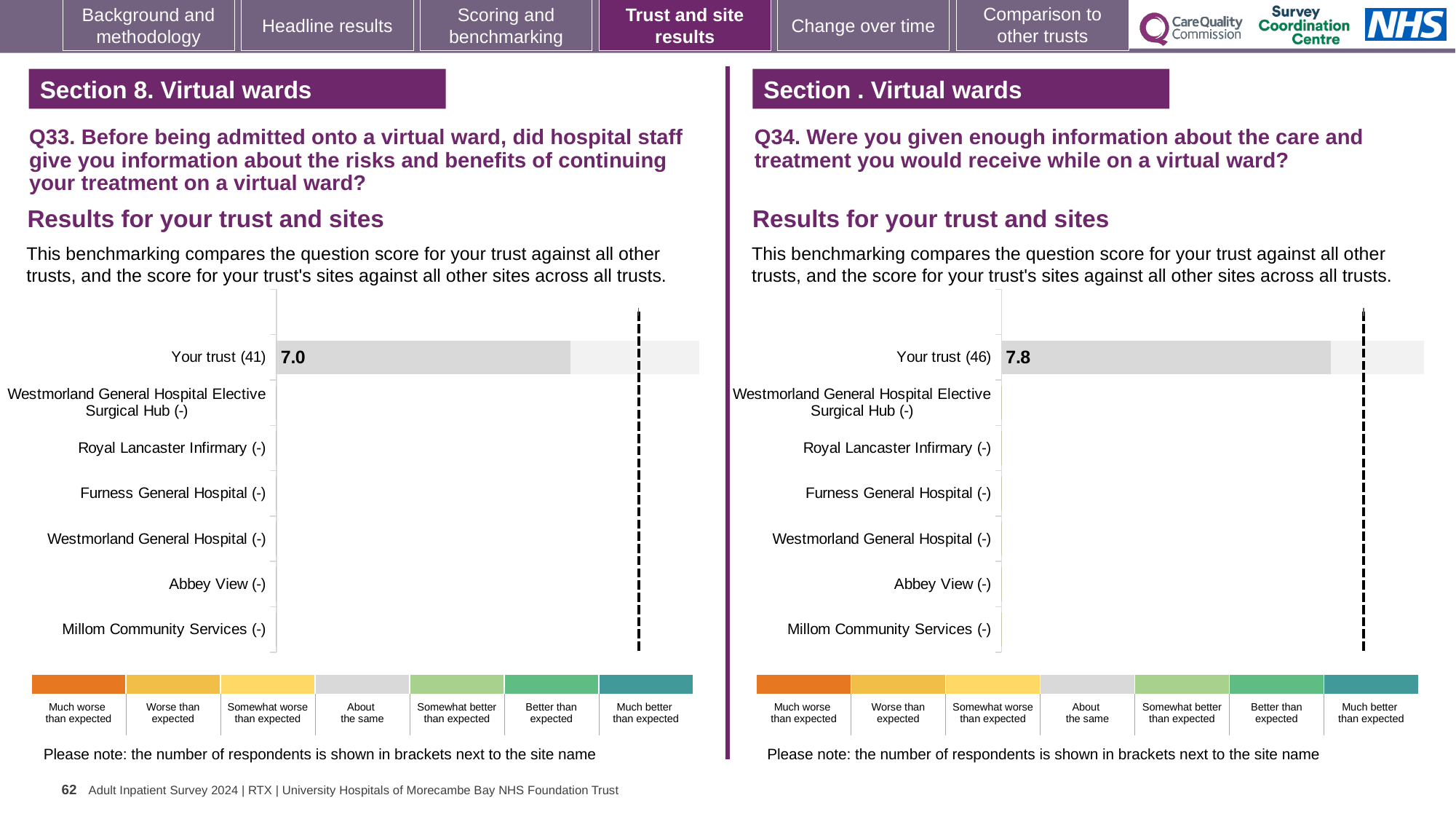
In the Q34 chart on the right, what is the label of the last row on the y axis? Millom Community Services (-) How many rows (categories) are listed on the y axis of the Q33 chart on the left? 7 What kind of chart is the Q33 chart on the left? Bar chart In the Q33 chart on the left, which row is the only one with a plotted bar? Your trust (41) In the Q33 chart on the left, what is the score shown for Your trust? 7.0 How many rows (categories) are listed on the y axis of the Q34 chart on the right? 7 What is the difference between the Your trust score in the Q34 chart on the right and the Your trust score in the Q33 chart on the left? 0.8 In the Q33 chart on the left, how many respondents are shown in brackets next to Your trust? 41 In the Q34 chart on the right, how many respondents are shown in brackets next to Your trust? 46 In the Q34 chart on the right, what is the score shown for Your trust? 7.8 How many colour bands does the key below the Q34 chart on the right show? 7 Which chart shows the higher score for Your trust, the Q33 chart on the left or the Q34 chart on the right? Q34 chart on the right